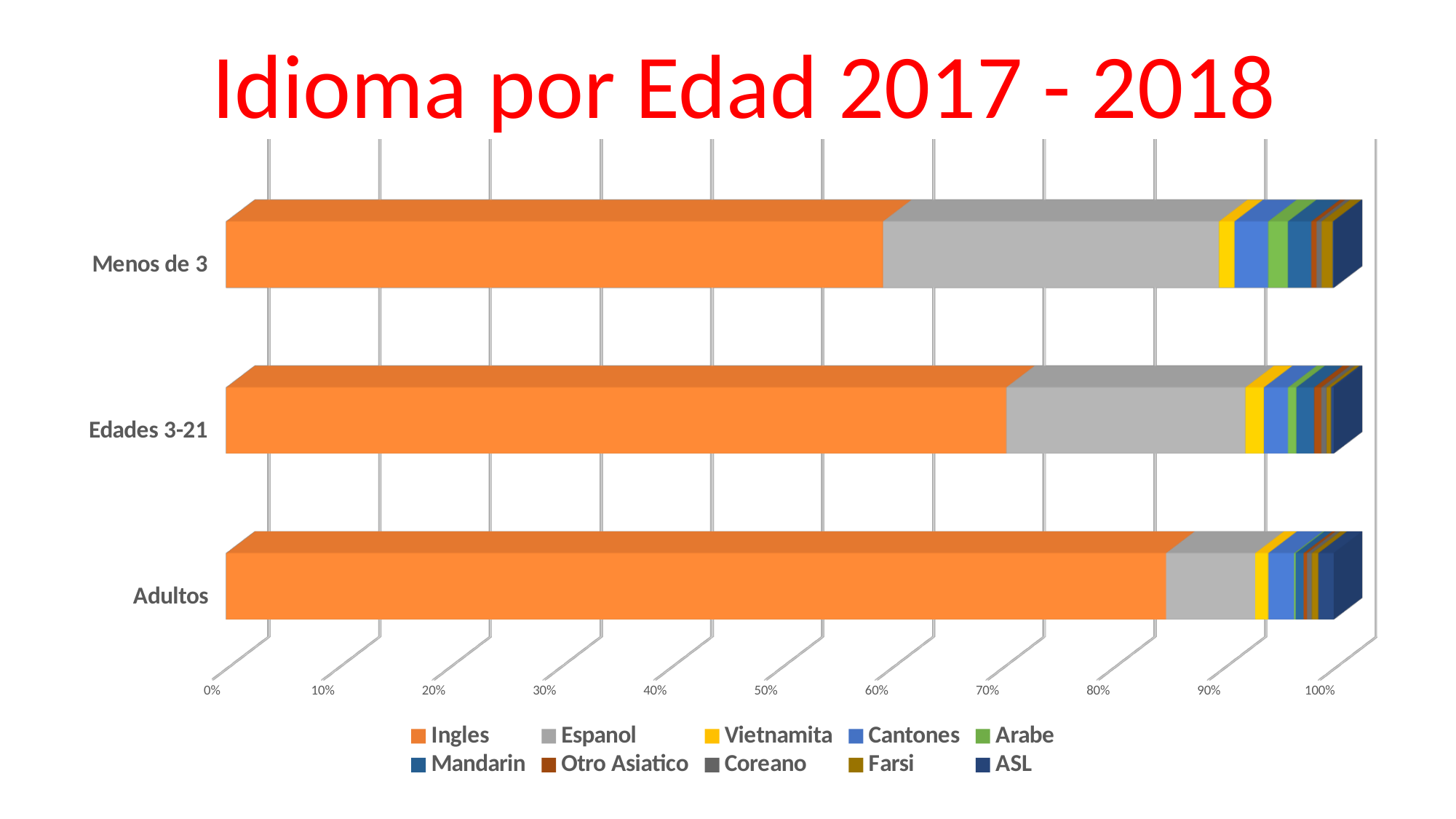
Which age category has the smallest Ingles share? Menos de 3 What kind of chart is shown on the slide? bar chart Which colour represents Ingles in the chart? orange Is the Ingles share for Edades 3-21 greater or less than 80%? less Is the Ingles share for Adultos greater or less than 80%? greater What is the title of the chart? Idioma por Edad 2017 - 2018 Is the Ingles share for Adultos greater or less than 90%? less Which age category has the largest Espanol share? Menos de 3 How many age categories are shown on the chart? 3 How many series does the legend list? 10 Which age category has the largest Ingles share? Adultos